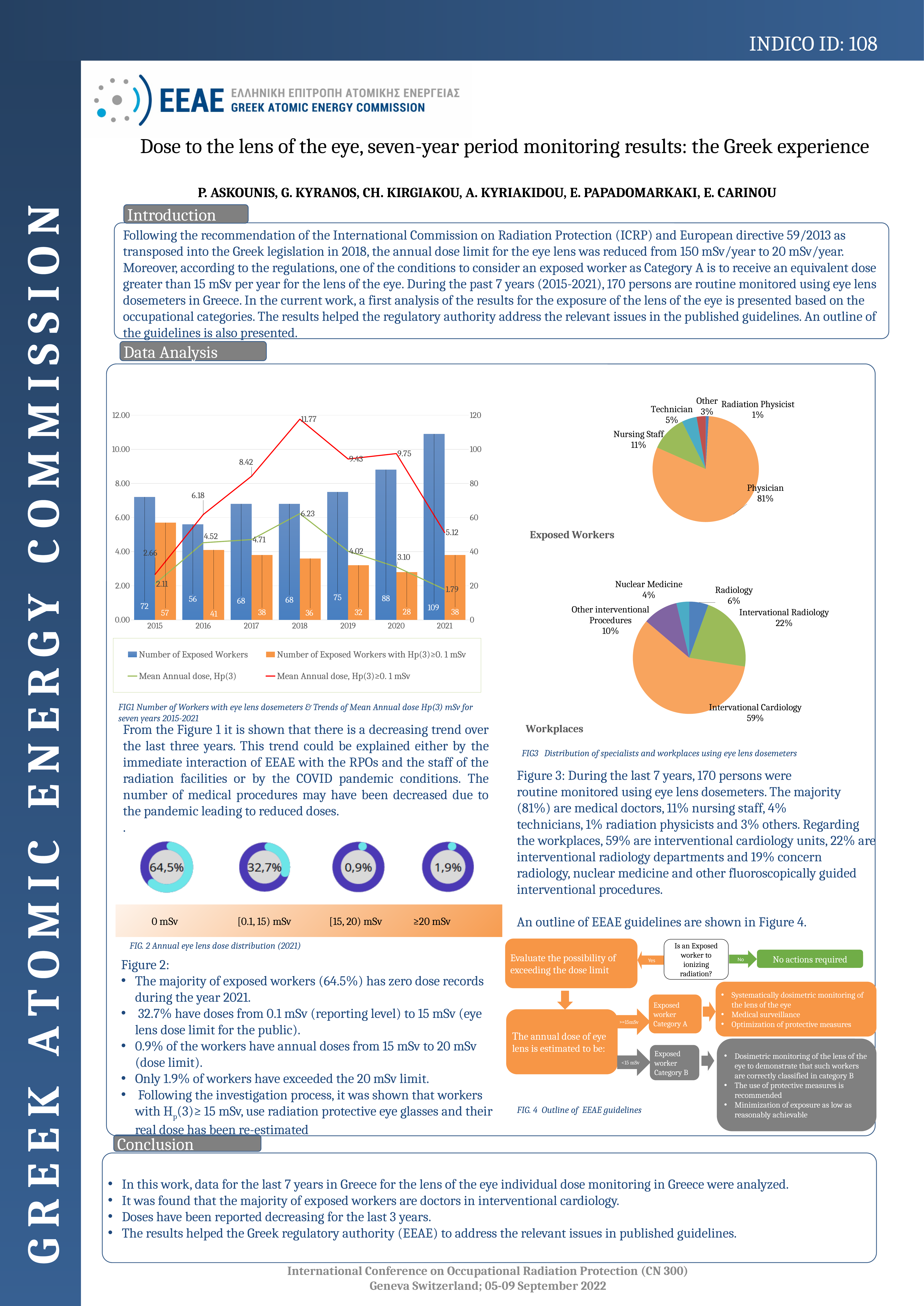
In Figure 1, how many series does the legend list? 4 In Figure 1, what was the mean annual dose Hp(3)≥0.1 mSv in 2018? 11.77 In Figure 1, what is the difference between the number of exposed workers in 2021 and in 2015? 37 In Figure 1, does the mean annual dose Hp(3) rise or fall from 2018 to 2021? fall In the Workplaces pie chart, which workplace has the largest share? Interventional Cardiology In Figure 1, which year had the lowest number of exposed workers with Hp(3)≥0.1 mSv? 2020 In the Exposed Workers pie chart, what share of workers are physicians? 81% In Figure 1, which year had the highest number of exposed workers? 2021 In Figure 1, how many exposed workers were there in 2021? 109 In Figure 2, what percentage of workers had annual doses in the [15, 20) mSv range? 0,9% In Figure 1, how many years are shown on the x axis? 7 In the Workplaces pie chart, is the share for Interventional Radiology larger or smaller than the share for Other interventional Procedures? larger